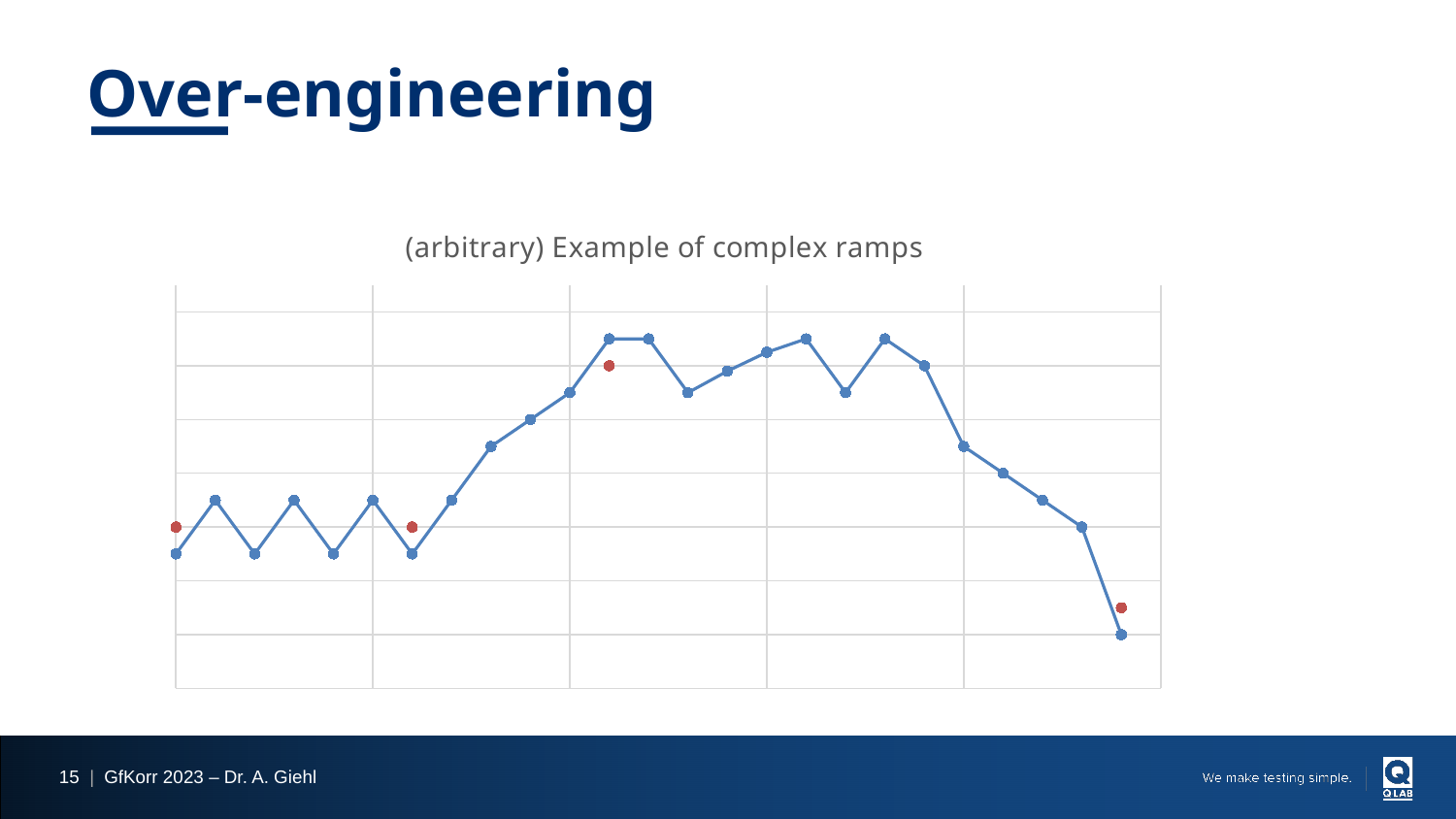
Is the last blue point on the right of the chart higher or lower than the first blue point on the left? lower Do the values of the blue line rise or fall over the last five points on the right side of the chart? fall How many red points are plotted on the chart? 4 Does the blue line rise or fall between the seventh point and the point where it first reaches its highest level? rise What colour is the connected line with markers on the chart? blue What is the title of the chart? (arbitrary) Example of complex ramps What kind of chart is shown on the slide? line chart Does the chart show any numeric axis labels? No Is the rightmost red point higher or lower than the leftmost red point? lower